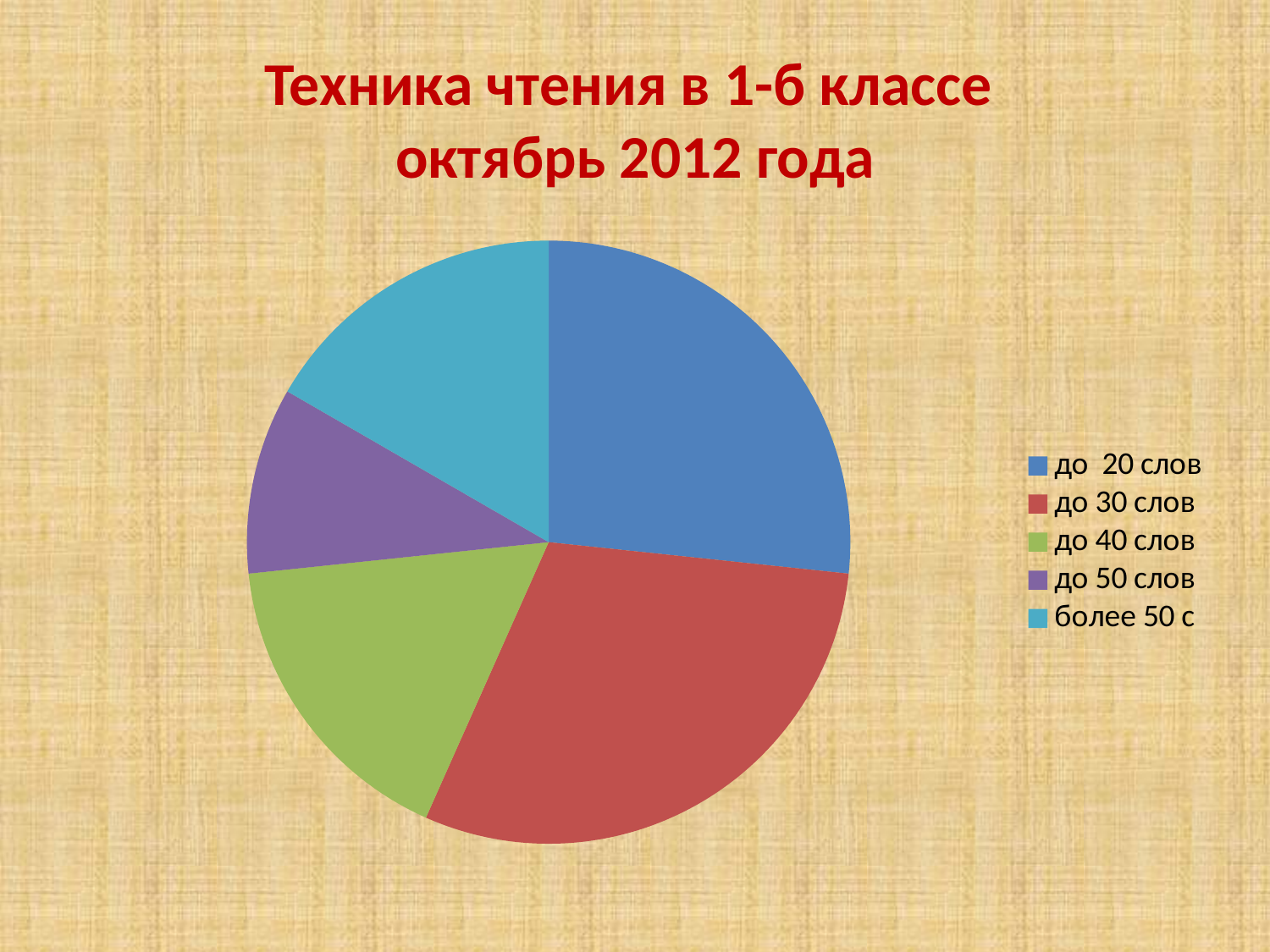
What kind of chart is shown on the slide? pie chart What is the title of the slide containing the chart? Техника чтения в 1-б классе октябрь 2012 года What colour is the slice for "до 40 слов"? green Which category has the smallest slice of the pie? до 50 слов How many slices does the pie chart have? 5 Which slice is larger: "до 30 слов" or "более 50 с"? до 30 слов Which slice is larger: "до 20 слов" or "до 50 слов"? до 20 слов How many entries does the legend list? 5 Which slice is larger: "до 30 слов" or "до 40 слов"? до 30 слов